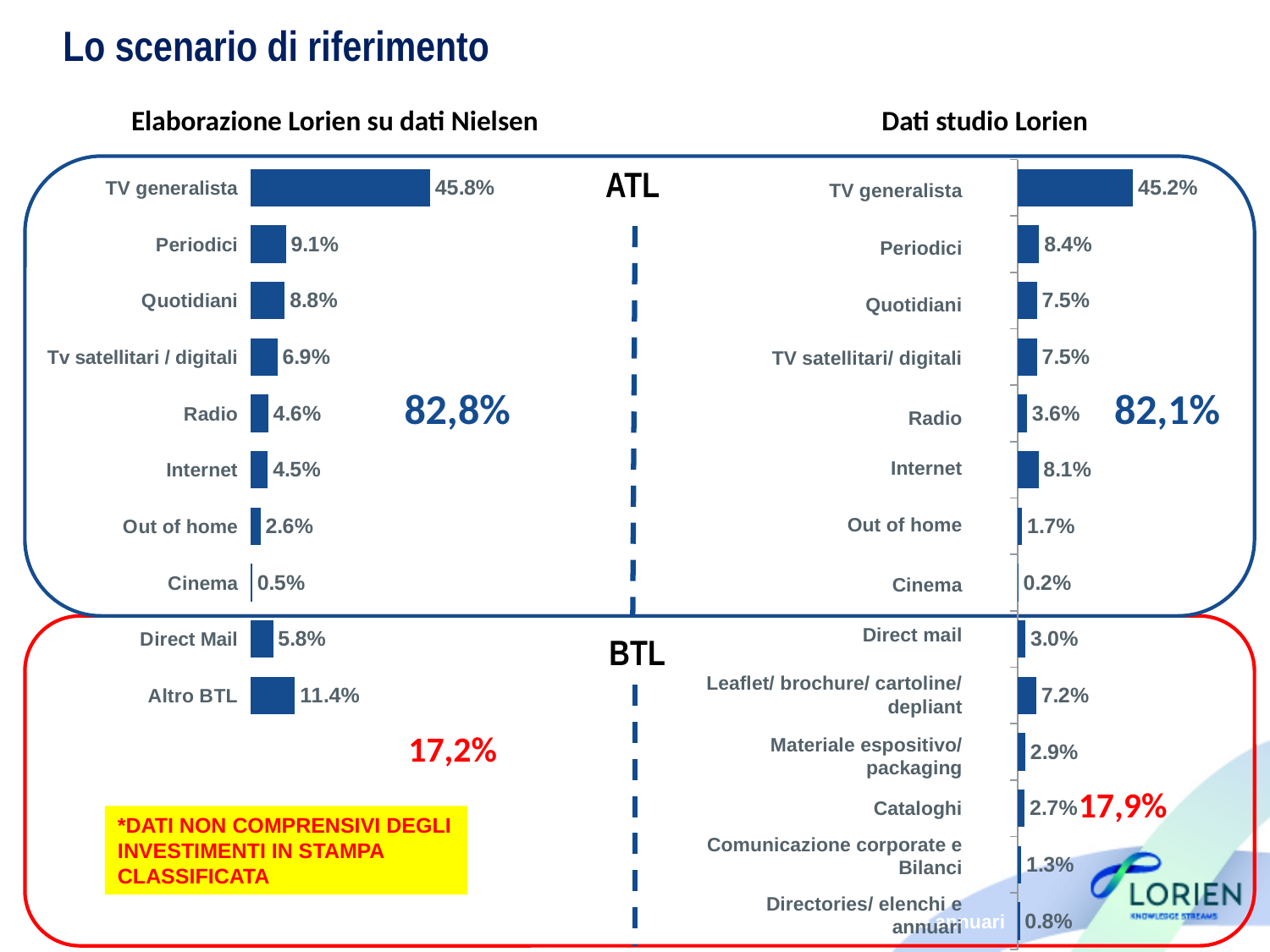
In the 'Elaborazione Lorien su dati Nielsen' chart, which is larger: Direct Mail or Out of home? Direct Mail In the 'Elaborazione Lorien su dati Nielsen' chart, what is the value for Periodici? 9.1% In the 'Elaborazione Lorien su dati Nielsen' chart, which category has the lowest value? Cinema In the 'Elaborazione Lorien su dati Nielsen' chart, what is the difference between TV generalista and Altro BTL? 34.4% How many categories are shown in the 'Dati studio Lorien' chart? 14 In the 'Dati studio Lorien' chart, which is larger: Internet or Quotidiani? Internet In the 'Dati studio Lorien' chart, what is the difference between Periodici and Radio? 4.8% In the 'Dati studio Lorien' chart, which category has the lowest value? Cinema What kind of chart is the 'Elaborazione Lorien su dati Nielsen' chart? Bar chart In the 'Elaborazione Lorien su dati Nielsen' chart, which category has the highest value? TV generalista In the 'Dati studio Lorien' chart, what is the value for Internet? 8.1% In the 'Dati studio Lorien' chart, what is the value for Leaflet/ brochure/ cartoline/ depliant? 7.2%